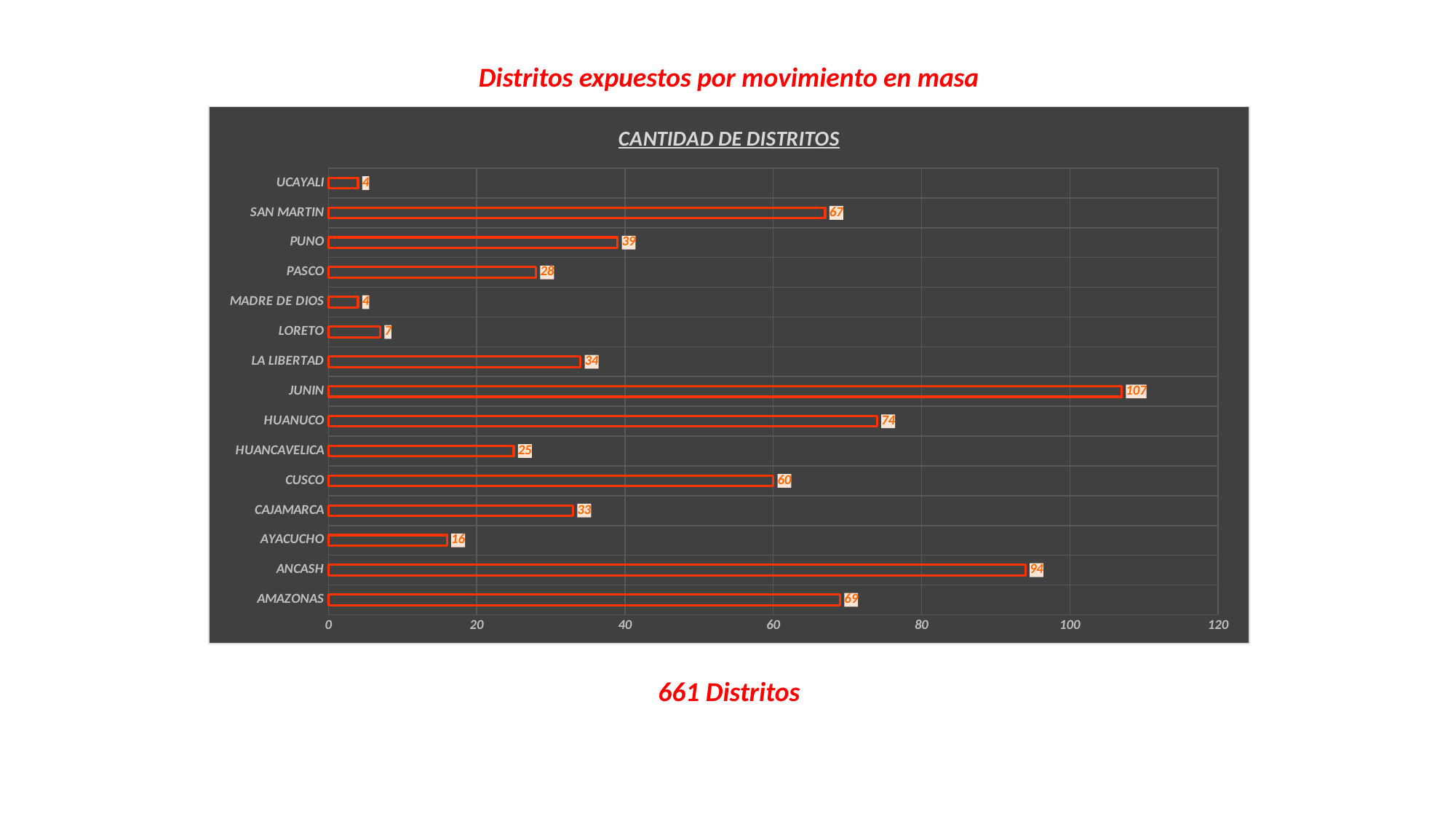
What is the value for ANCASH? 94 What is the difference between the values for JUNIN and ANCASH? 13 How many categories are shown on the chart? 15 What is the title of the chart? CANTIDAD DE DISTRITOS Is the value for PUNO greater or less than 40? less What is the value for HUANCAVELICA? 25 Which category has the highest value? JUNIN What is the value for JUNIN? 107 What kind of chart is shown? bar chart What is the difference between the values for HUANUCO and CUSCO? 14 What is the value for LORETO? 7 Which is larger, the value for SAN MARTIN or the value for AMAZONAS? AMAZONAS